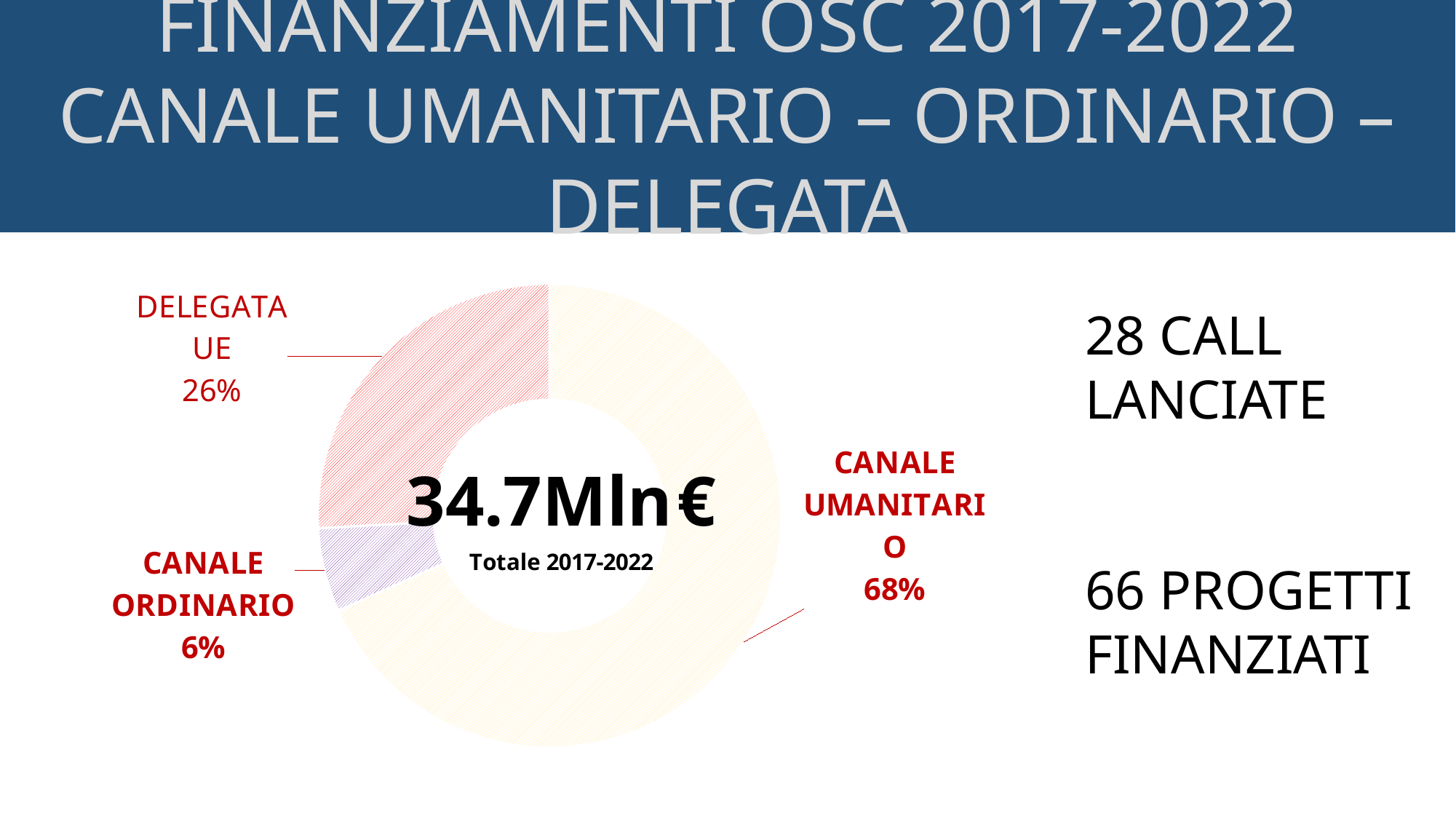
What is the combined share of DELEGATA UE and CANALE ORDINARIO? 32% What period does the total in the centre of the chart refer to? 2017-2022 Which is larger, the share for DELEGATA UE or the share for CANALE ORDINARIO? DELEGATA UE What is the difference in percentage points between the CANALE UMANITARIO share and the DELEGATA UE share? 42 What kind of chart is shown on the slide? Doughnut chart What share of the chart does CANALE UMANITARIO represent? 68% What share of the chart does CANALE ORDINARIO represent? 6% Which category has the largest share of the chart? CANALE UMANITARIO Which category has the smallest share of the chart? CANALE ORDINARIO How many categories does the chart show? 3 What total value is printed in the centre of the chart? 34.7Mln€ What share of the chart does DELEGATA UE represent? 26%